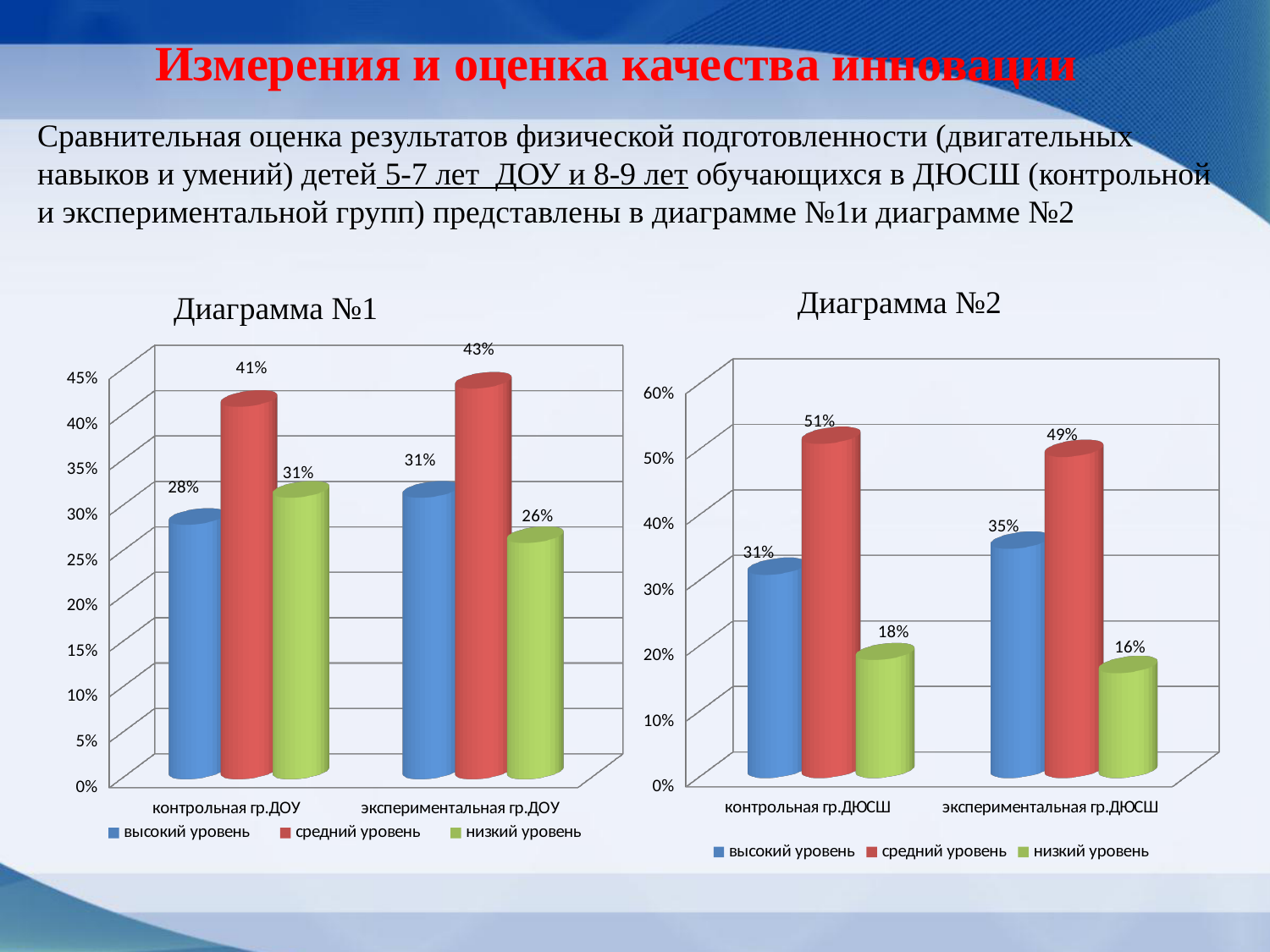
In Диаграмма №1, what is the value for средний уровень in the контрольная гр.ДОУ group? 41% In Диаграмма №1, what is the value for низкий уровень in the экспериментальная гр.ДОУ group? 26% What kind of chart is Диаграмма №2? bar chart In Диаграмма №1, which level has the lowest value in the экспериментальная гр.ДОУ group? низкий уровень In Диаграмма №1, which is larger: высокий уровень for контрольная гр.ДОУ or высокий уровень for экспериментальная гр.ДОУ? экспериментальная гр.ДОУ In Диаграмма №2, what is the difference between средний уровень in the контрольная гр.ДЮСШ group and средний уровень in the экспериментальная гр.ДЮСШ group? 2% How many groups (categories) are shown on the x axis of Диаграмма №1? 2 In Диаграмма №2, what is the value for низкий уровень in the контрольная гр.ДЮСШ group? 18% In Диаграмма №2, which level has the highest value in the контрольная гр.ДЮСШ group? средний уровень How many series does the legend of Диаграмма №2 list? 3 In Диаграмма №2, what is the value for высокий уровень in the экспериментальная гр.ДЮСШ group? 35% In Диаграмма №1, what is the difference between средний уровень and высокий уровень in the контрольная гр.ДОУ group? 13%